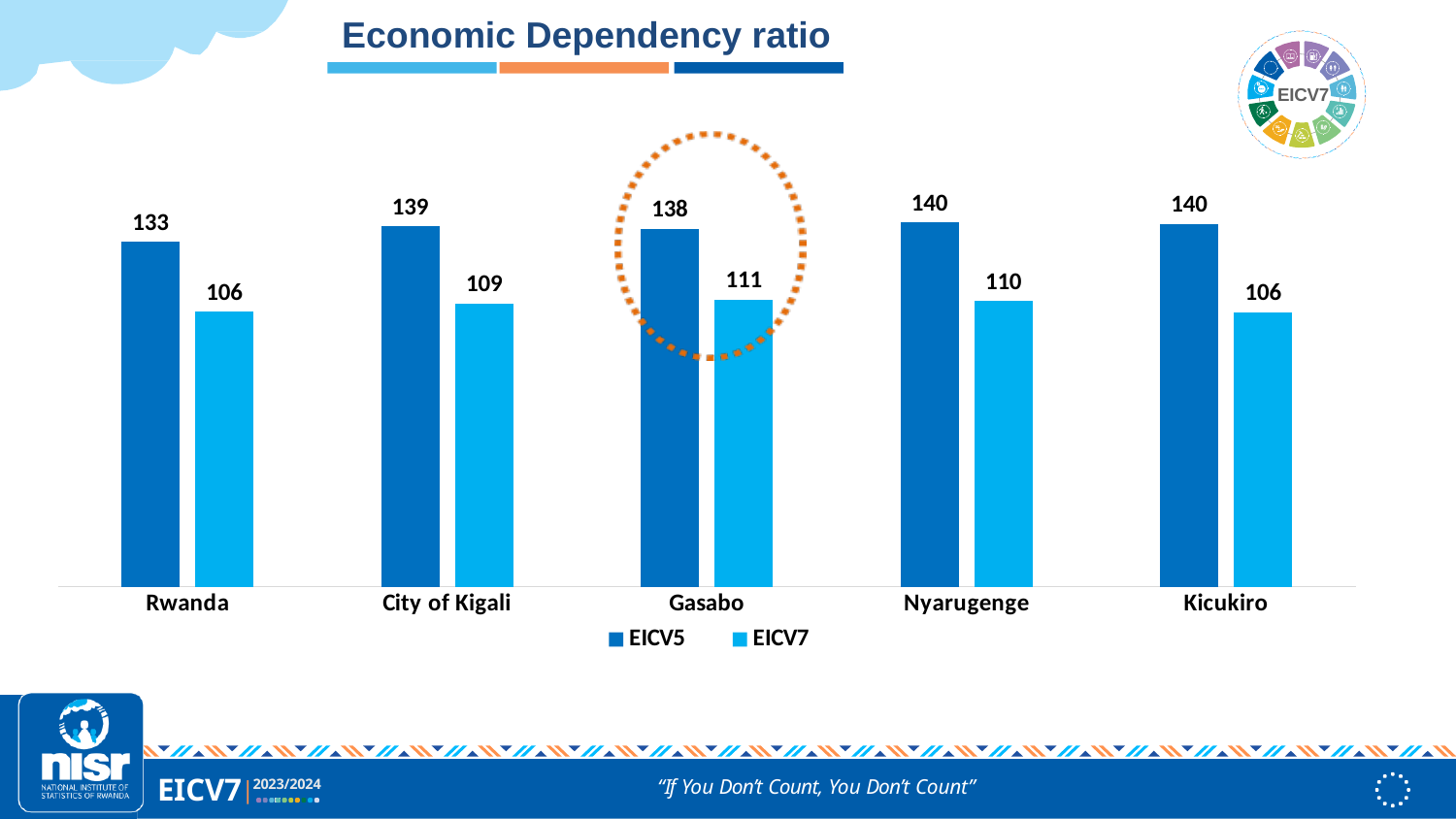
What is the difference between the EICV5 values for City of Kigali and Rwanda? 6 What is the EICV7 value for Gasabo? 111 What is the EICV5 value for Rwanda? 133 What is the EICV7 value for Nyarugenge? 110 Which category has the lowest EICV7 value? Rwanda and Kicukiro (106) Which is larger, the EICV5 value for Gasabo or the EICV5 value for Nyarugenge? Nyarugenge Which category has the highest EICV7 value? Gasabo What kind of chart is shown on the slide? Bar chart What is the difference between the EICV5 and EICV7 values for Kicukiro? 34 How many categories are shown on the x axis? 5 How many series does the legend list? 2 What is the title of the chart? Economic Dependency ratio